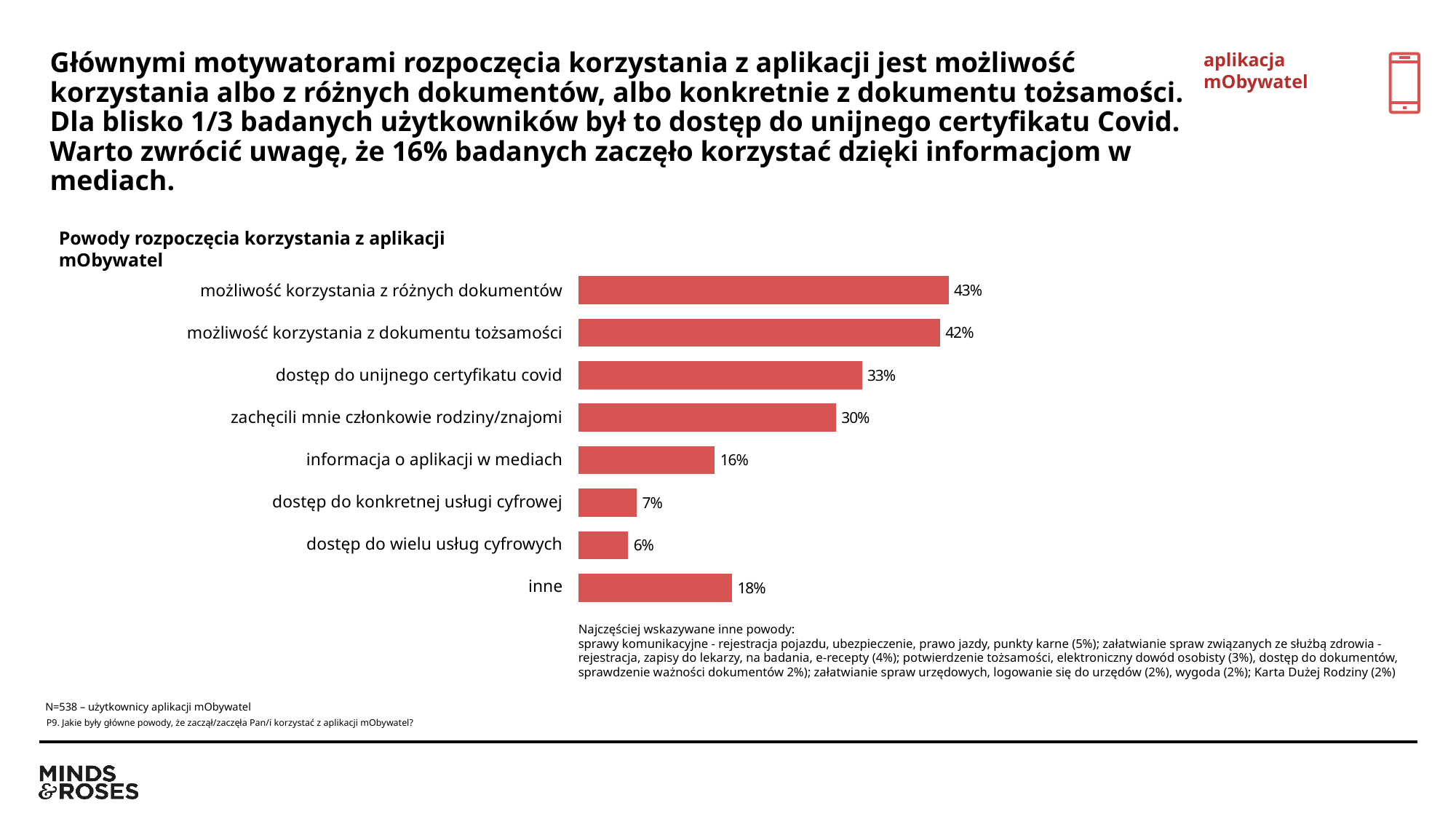
What is the difference between "dostęp do konkretnej usługi cyfrowej" and "dostęp do wielu usług cyfrowych"? 1% What is the value for "możliwość korzystania z różnych dokumentów"? 43% What is the value for "informacja o aplikacji w mediach"? 16% What is the value for "inne"? 18% How many categories are shown in the chart? 8 Which category has the highest value? możliwość korzystania z różnych dokumentów What is the title of the chart? Powody rozpoczęcia korzystania z aplikacji mObywatel What is the value for "dostęp do unijnego certyfikatu covid"? 33% Which category has the lowest value? dostęp do wielu usług cyfrowych What kind of chart is shown on the slide? bar chart Which is larger: "dostęp do konkretnej usługi cyfrowej" or "inne"? inne What is the difference between "możliwość korzystania z dokumentu tożsamości" and "zachęcili mnie członkowie rodziny/znajomi"? 12%